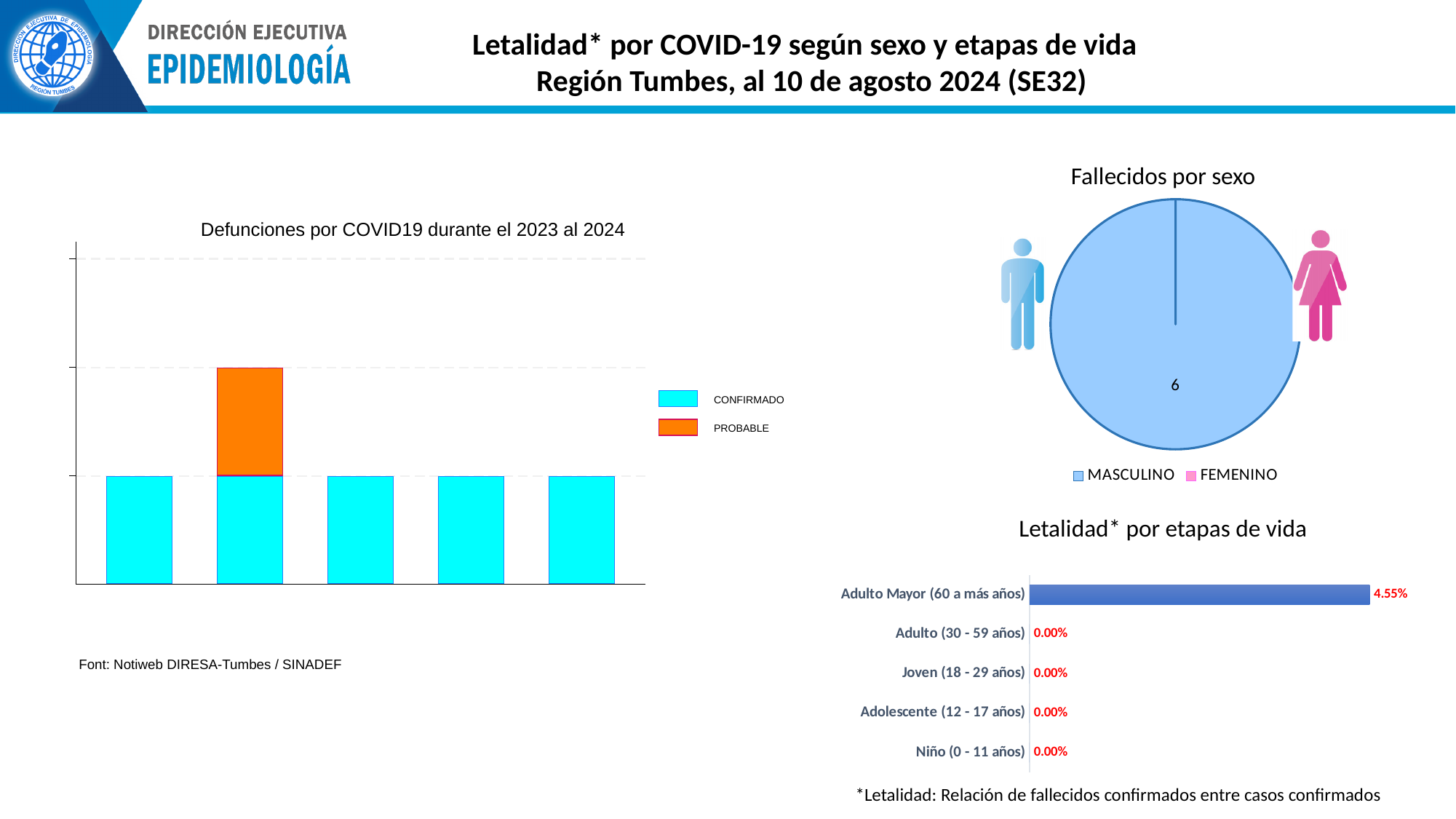
In the 'Letalidad* por etapas de vida' chart, what is the value for Adulto (30 - 59 años)? 0.00% In the 'Letalidad* por etapas de vida' chart, which age group has the highest value? Adulto Mayor (60 a más años) How many series does the legend of the 'Defunciones por COVID19 durante el 2023 al 2024' chart list? 2 How many entries does the legend of the 'Fallecidos por sexo' chart list? 2 In the 'Fallecidos por sexo' chart, what value is shown for MASCULINO? 6 In the 'Letalidad* por etapas de vida' chart, what is the difference between the values for Adulto Mayor (60 a más años) and Joven (18 - 29 años)? 4.55% What kind of chart is 'Letalidad* por etapas de vida'? Bar chart What kind of chart is 'Defunciones por COVID19 durante el 2023 al 2024'? Bar chart In the 'Defunciones por COVID19 durante el 2023 al 2024' chart, which series is shown in orange according to the legend? PROBABLE In the 'Letalidad* por etapas de vida' chart, how many age groups are shown? 5 In the 'Letalidad* por etapas de vida' chart, what is the value for Adulto Mayor (60 a más años)? 4.55% What kind of chart is 'Fallecidos por sexo'? Pie chart